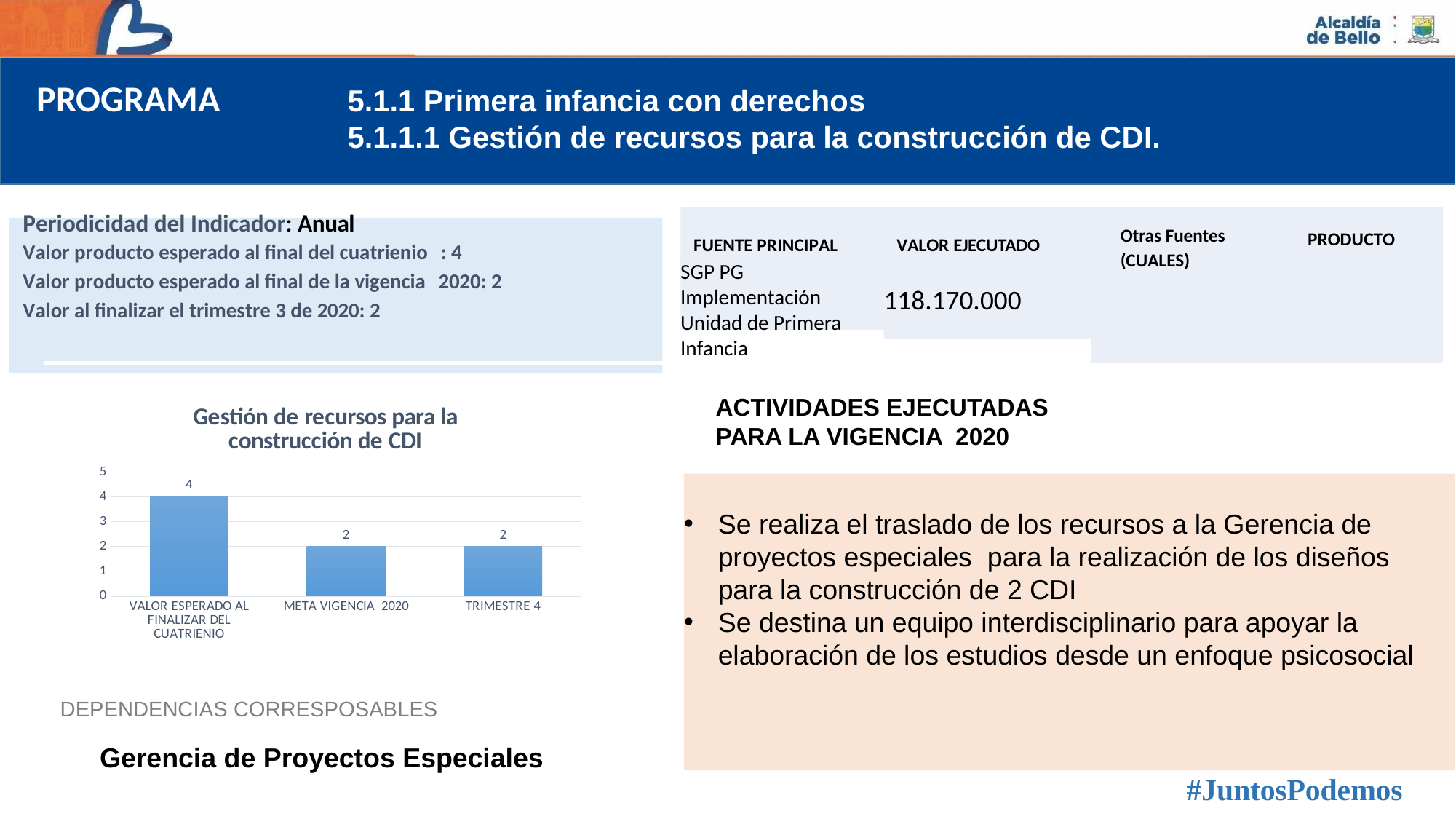
Which is larger: the value for VALOR ESPERADO AL FINALIZAR DEL CUATRIENIO or the value for TRIMESTRE 4? VALOR ESPERADO AL FINALIZAR DEL CUATRIENIO What is the highest value shown on the chart's vertical axis? 5 What is the value for VALOR ESPERADO AL FINALIZAR DEL CUATRIENIO in the chart? 4 How many categories are shown in the chart? 3 What is the value for META VIGENCIA 2020 in the chart? 2 Which category has the highest value in the chart? VALOR ESPERADO AL FINALIZAR DEL CUATRIENIO What is the difference between the value for VALOR ESPERADO AL FINALIZAR DEL CUATRIENIO and the value for META VIGENCIA 2020? 2 Is the value for VALOR ESPERADO AL FINALIZAR DEL CUATRIENIO greater or less than 3? greater What is the title of the chart? Gestión de recursos para la construcción de CDI What is the value for TRIMESTRE 4 in the chart? 2 What kind of chart is shown on the slide? bar chart Do the values for META VIGENCIA 2020 and TRIMESTRE 4 differ? No, both are 2